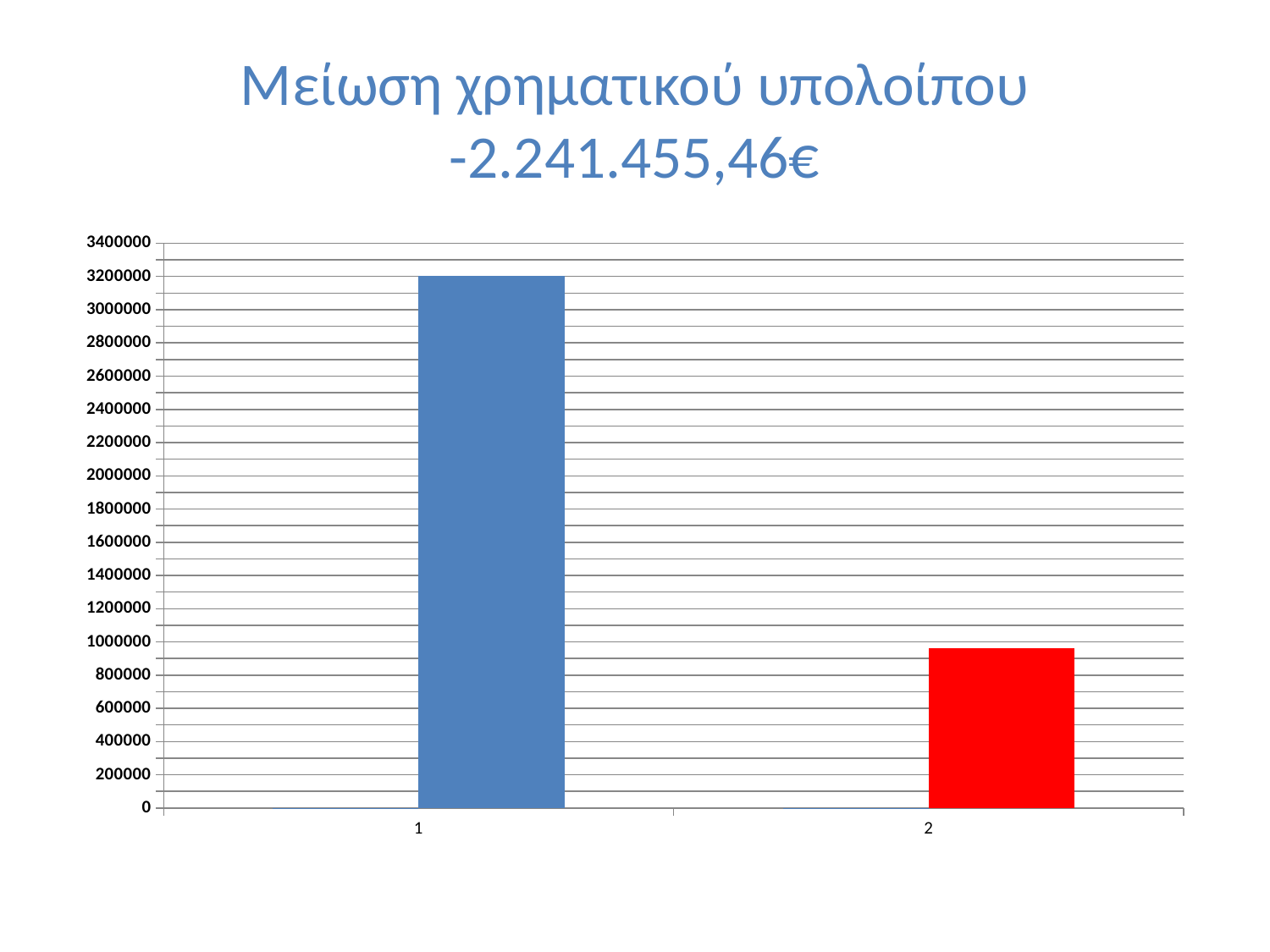
What colour is the bar for category 2? red Is the value for category 2 greater or less than 800000? greater Do the values rise or fall from category 1 to category 2? fall Which is larger, the value for category 1 or the value for category 2? 1 Is the value for category 2 greater or less than 1000000? less Is the value for category 1 greater or less than 3000000? greater Which category has the highest bar? 1 Which category has the lowest bar? 2 What amount is shown in the slide title below 'Μείωση χρηματικού υπολοίπου'? -2.241.455,46€ What kind of chart is shown on the slide? bar chart How many bars are plotted in the chart? 2